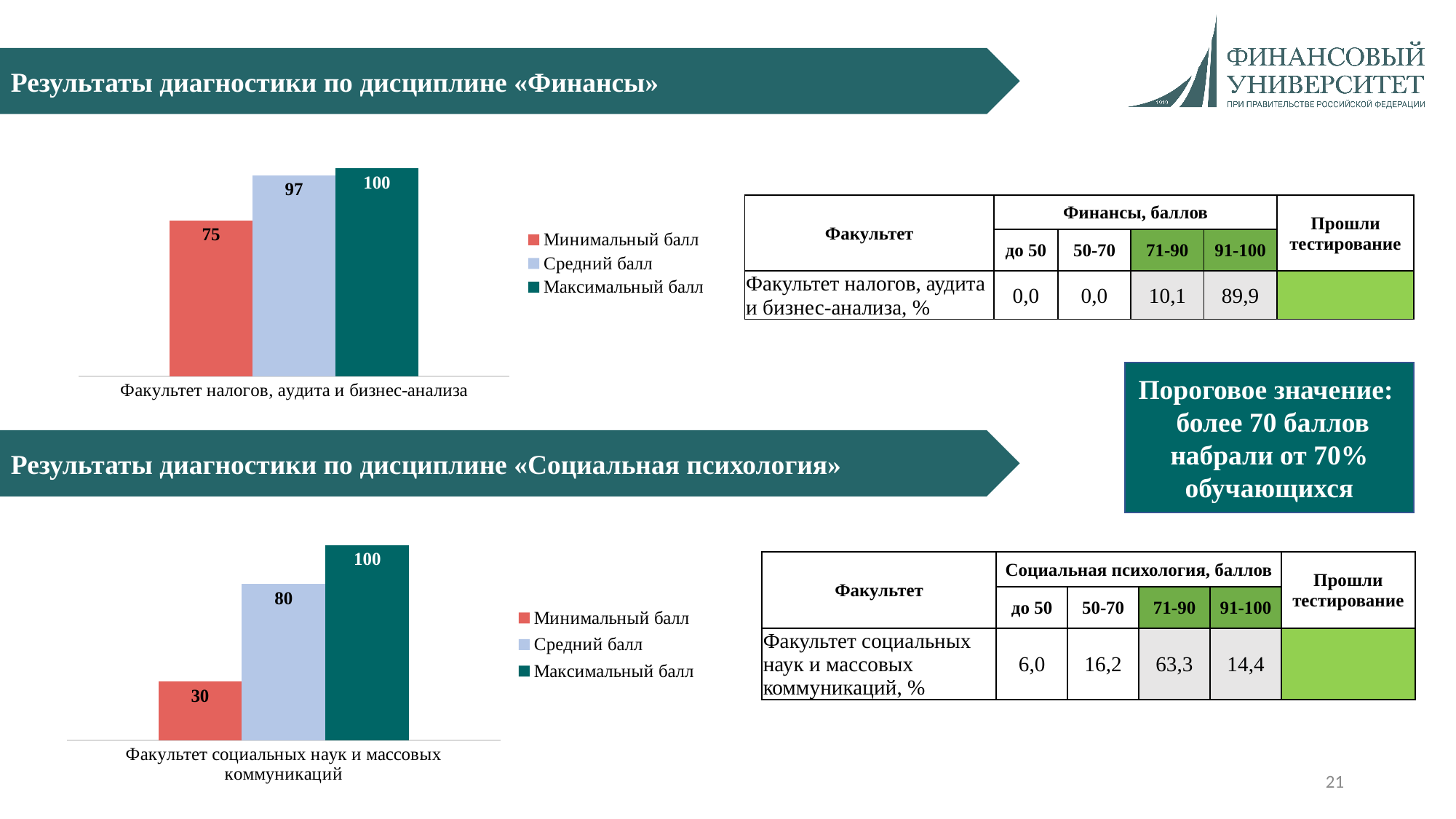
How many series does the legend of the bottom chart (Социальная психология) list? 3 In the top chart (Финансы), what is the value of Минимальный балл for Факультет налогов, аудита и бизнес-анализа? 75 Which is larger: Средний балл in the top chart (Финансы) or Средний балл in the bottom chart (Социальная психология)? Top chart (Финансы), 97 In the top chart (Финансы), what is the difference between Средний балл and Минимальный балл? 22 In the bottom chart (Социальная психология), what is the difference between Максимальный балл and Минимальный балл? 70 In the top chart (Финансы), what is the value of Средний балл? 97 In the top chart (Финансы), what is the value of Максимальный балл? 100 In the bottom chart (Социальная психология), which series has the lowest value? Минимальный балл In the bottom chart (Социальная психология), what is the value of Минимальный балл for Факультет социальных наук и массовых коммуникаций? 30 What type of chart is the top chart (Финансы)? Bar chart In the top chart (Финансы), which series has the highest value? Максимальный балл In the bottom chart (Социальная психология), what is the value of Средний балл? 80